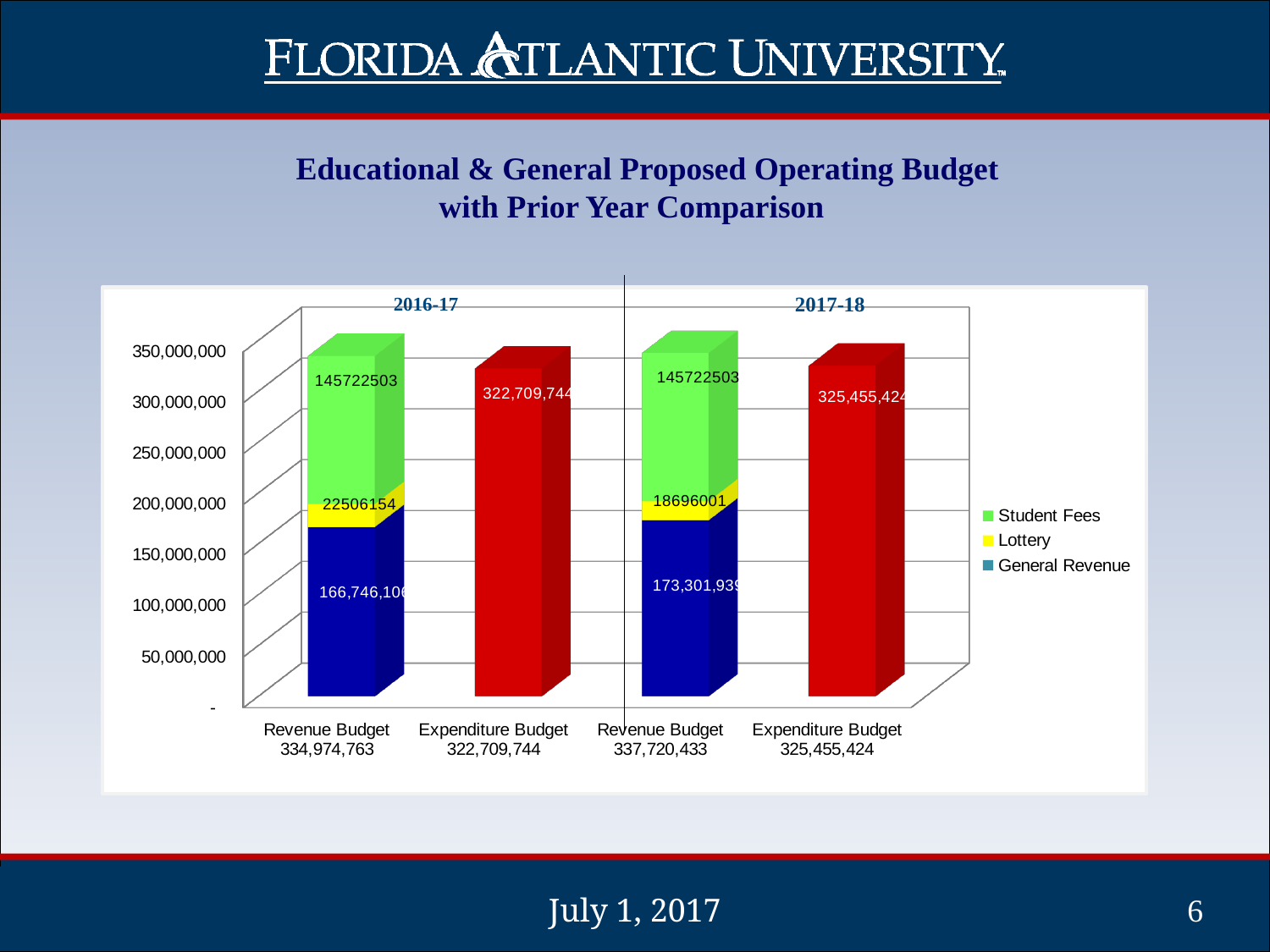
Is the General Revenue value for the 2016-17 Revenue Budget greater or less than 150,000,000? greater What is the Lottery value for the 2017-18 Revenue Budget bar? 18696001 Which year has the larger Lottery value, 2016-17 or 2017-18? 2016-17 What is the total of the 2016-17 Revenue Budget stacked bar? 334,974,763 By how much does the 2017-18 Expenditure Budget exceed the 2016-17 Expenditure Budget? 2,745,680 Which year has the larger Expenditure Budget, 2016-17 or 2017-18? 2017-18 How many series does the legend list? 3 What is the value of the 2017-18 Expenditure Budget bar? 325,455,424 Which bar has the highest total value? 2017-18 Revenue Budget What kind of chart is shown on the slide? Stacked bar chart What is the difference between the Lottery value in 2016-17 and the Lottery value in 2017-18? 3810153 What is the Student Fees value for the 2016-17 Revenue Budget bar? 145722503